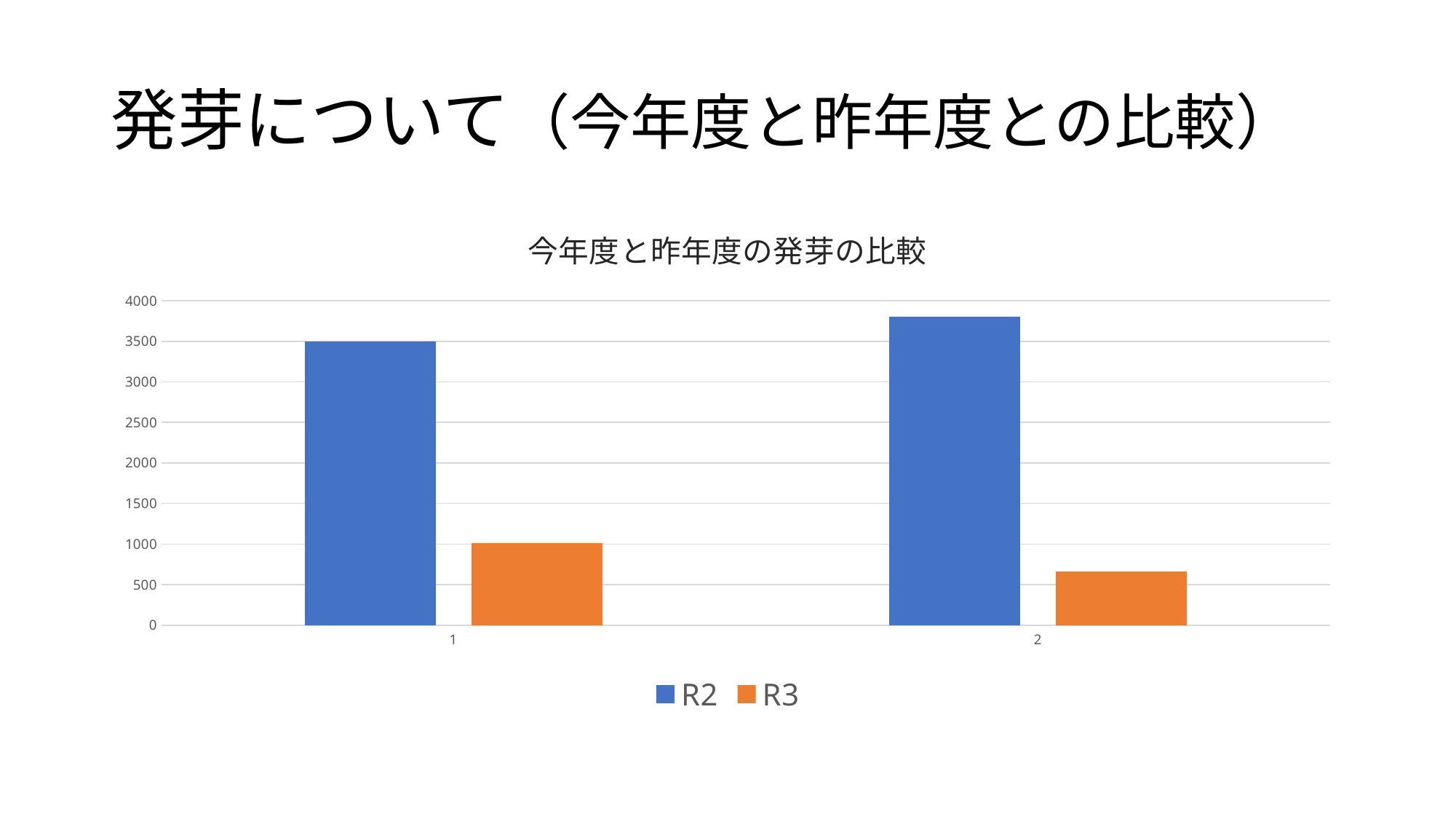
What is the title of the chart? 今年度と昨年度の発芽の比較 What kind of chart is shown on the slide? Bar chart Is the value of R2 for category 2 greater or less than 3500? greater Which colour represents the R2 series? Blue Is the value of R3 for category 1 greater or less than 1500? less Which bar is the shortest in the chart? R3 for category 2 Which bar is the tallest in the chart? R2 for category 2 For category 1, which series has the larger value, R2 or R3? R2 Is the value of R3 for category 2 greater or less than 1000? less How many series does the legend list? 2 How many categories are shown on the x axis? 2 What is the value of R2 for category 1? 3500